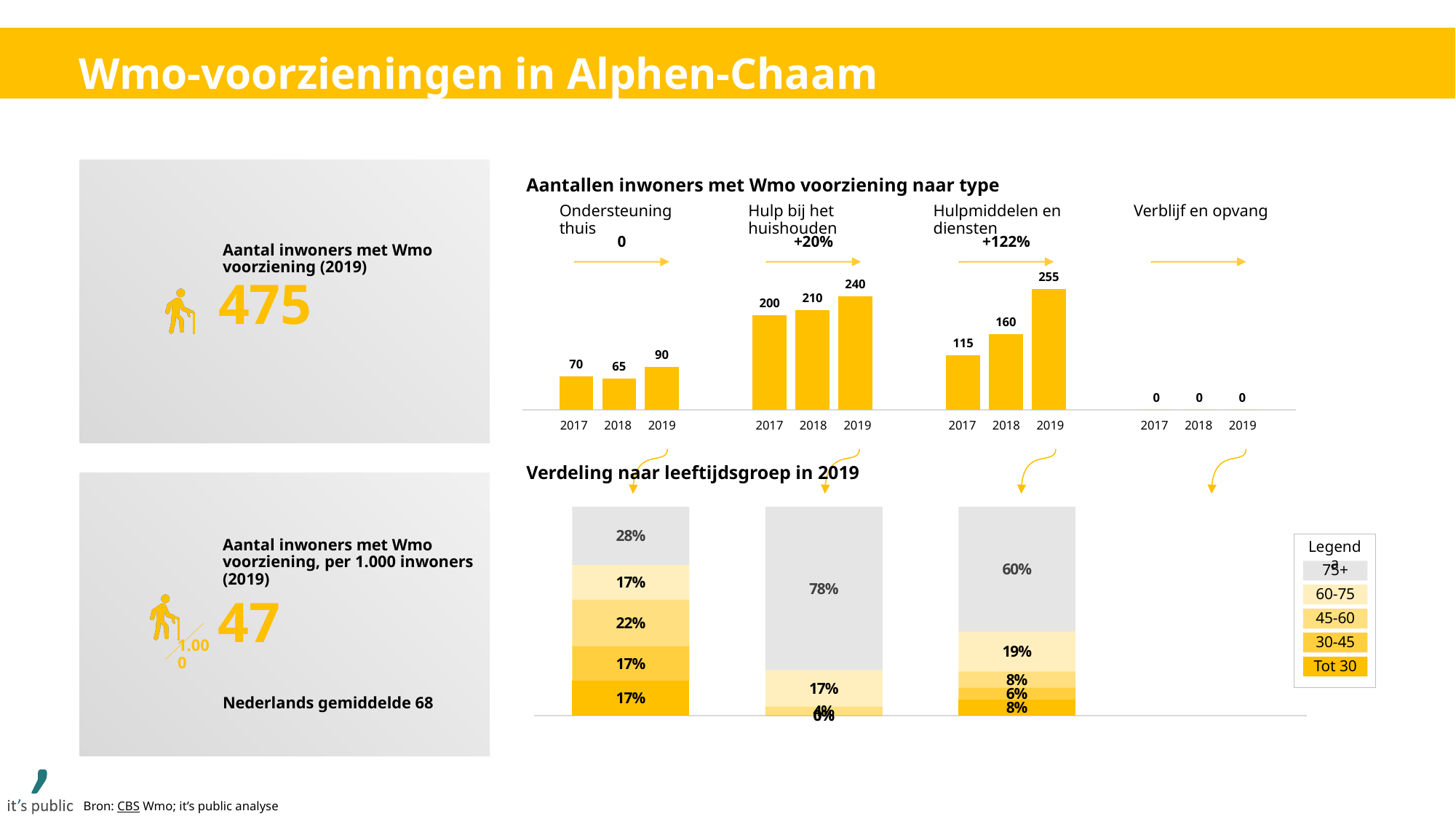
In the chart 'Aantallen inwoners met Wmo voorziening naar type', which is larger: Ondersteuning thuis in 2019 or Hulp bij het huishouden in 2017? Hulp bij het huishouden in 2017 In the chart 'Verdeling naar leeftijdsgroep in 2019', what share of the Hulpmiddelen en diensten bar is the 60-75 age group? 19% In the chart 'Aantallen inwoners met Wmo voorziening naar type', which year has the lowest value for Ondersteuning thuis? 2018 In the chart 'Aantallen inwoners met Wmo voorziening naar type', what is the value for Hulpmiddelen en diensten in 2017? 115 In the chart 'Aantallen inwoners met Wmo voorziening naar type', do the values for Hulp bij het huishouden rise or fall from 2017 to 2019? rise In the chart 'Aantallen inwoners met Wmo voorziening naar type', what is the value for Verblijf en opvang in 2018? 0 In the chart 'Aantallen inwoners met Wmo voorziening naar type', which type has the highest value in 2019? Hulpmiddelen en diensten In the chart 'Verdeling naar leeftijdsgroep in 2019', what share of the Ondersteuning thuis bar is the 75+ age group? 28% What kind of chart is 'Verdeling naar leeftijdsgroep in 2019'? stacked bar chart In the chart 'Aantallen inwoners met Wmo voorziening naar type', what is the difference between the 2019 and 2017 values for Hulpmiddelen en diensten? 140 In the chart 'Aantallen inwoners met Wmo voorziening naar type', what is the value for Hulp bij het huishouden in 2019? 240 How many age groups does the legend of the chart 'Verdeling naar leeftijdsgroep in 2019' list? 5